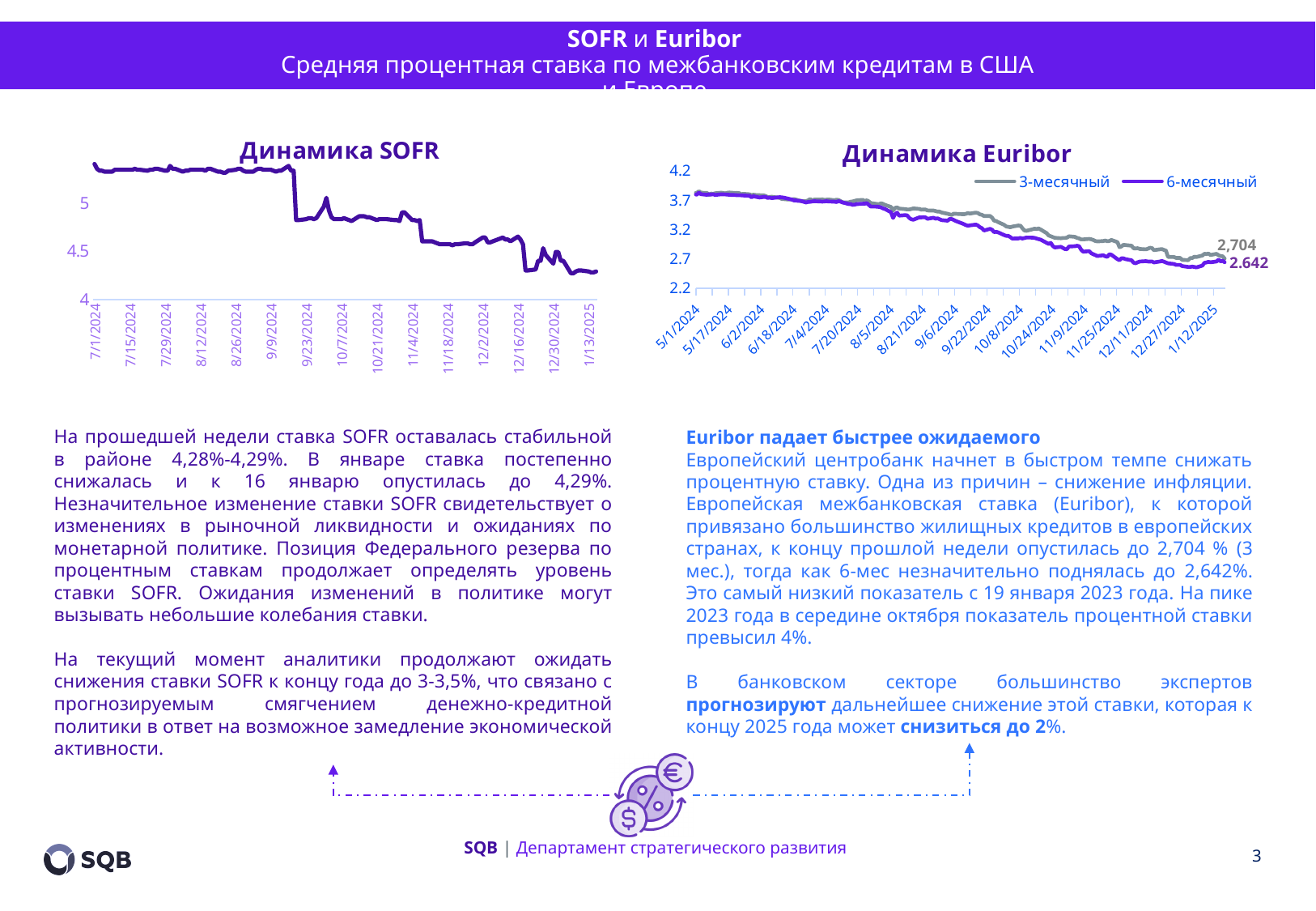
In the "Динамика Euribor" chart, which series has the higher final labelled value, 3-месячный or 6-месячный? 3-месячный What kind of chart is the "Динамика Euribor" chart? line chart In the "Динамика SOFR" chart, is the SOFR value at 1/13/2025 greater or less than 4.5? less In the "Динамика Euribor" chart, what is the difference between the final labelled values of the 3-месячный and 6-месячный series? 0.062 What are the legend entries of the "Динамика Euribor" chart? 3-месячный, 6-месячный In the "Динамика SOFR" chart, is the SOFR value at 7/1/2024 greater or less than 5? greater In the "Динамика Euribor" chart, what is the last labelled value of the 6-месячный series? 2.642 In the "Динамика SOFR" chart, does the SOFR rate rise or fall from 7/1/2024 to 1/13/2025? fall In the "Динамика Euribor" chart, do the Euribor rates rise or fall over the period shown? fall How many series does the legend of the "Динамика Euribor" chart list? 2 What kind of chart is the "Динамика SOFR" chart? line chart In the "Динамика Euribor" chart, what is the last labelled value of the 3-месячный series? 2,704